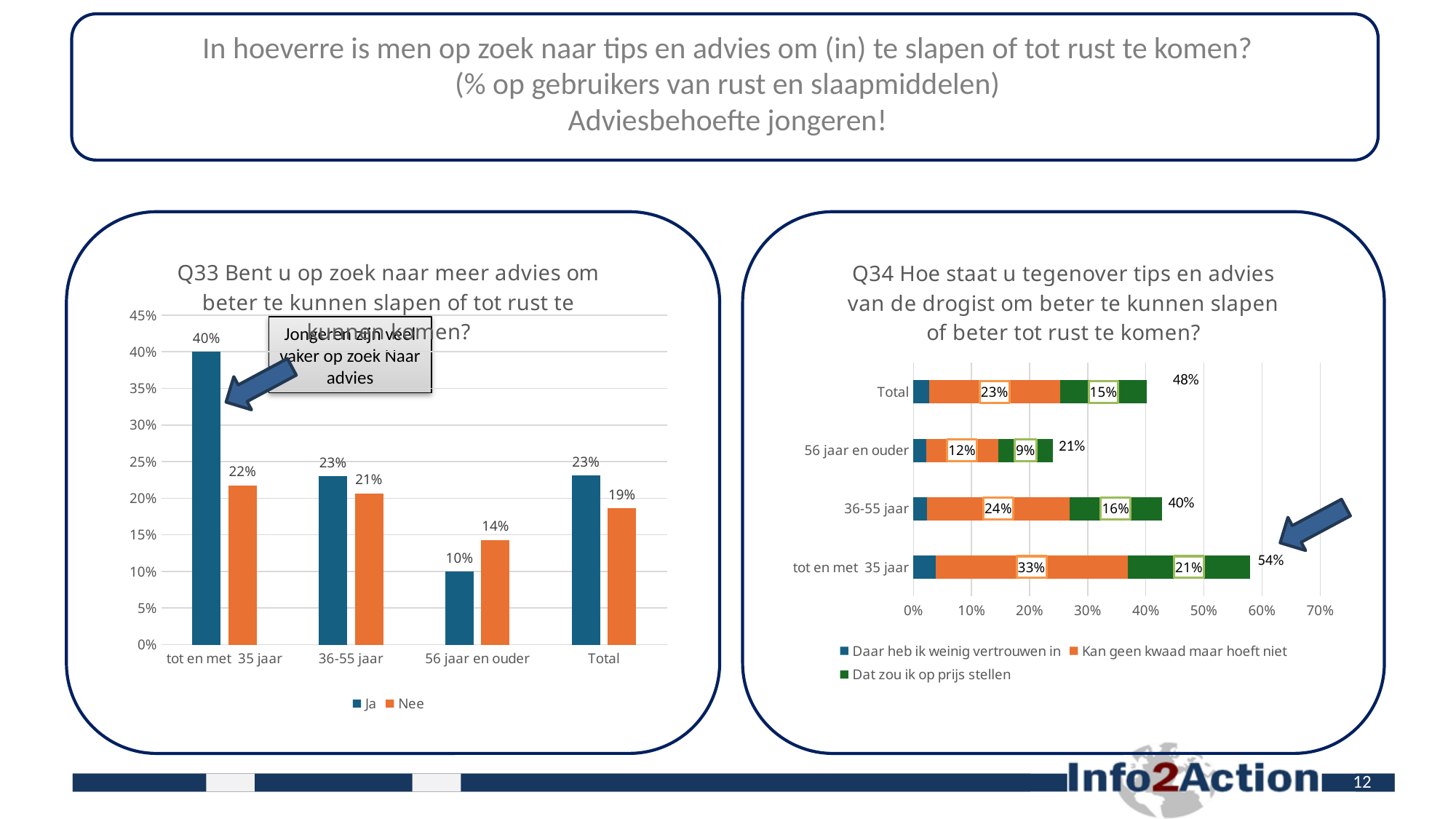
In the Q34 chart, how many categories are shown on the vertical axis? 4 In the Q33 chart, what is the 'Ja' value for 'tot en met 35 jaar'? 40% What kind of chart is the Q33 chart? bar chart In the Q34 chart, how many series does the legend list? 3 In the Q33 chart, for '56 jaar en ouder', which is larger: 'Ja' or 'Nee'? Nee In the Q33 chart, what is the difference between the 'Ja' and 'Nee' values for 'tot en met 35 jaar'? 18% In the Q33 chart, how many series does the legend list? 2 In the Q33 chart, which category has the highest 'Ja' value? tot en met 35 jaar In the Q34 chart, what is the 'Kan geen kwaad maar hoeft niet' value for 'tot en met 35 jaar'? 33% In the Q34 chart, what is the 'Dat zou ik op prijs stellen' value for '56 jaar en ouder'? 9% In the Q33 chart, what is the 'Nee' value for '56 jaar en ouder'? 14% In the Q33 chart, which category has the lowest 'Ja' value? 56 jaar en ouder